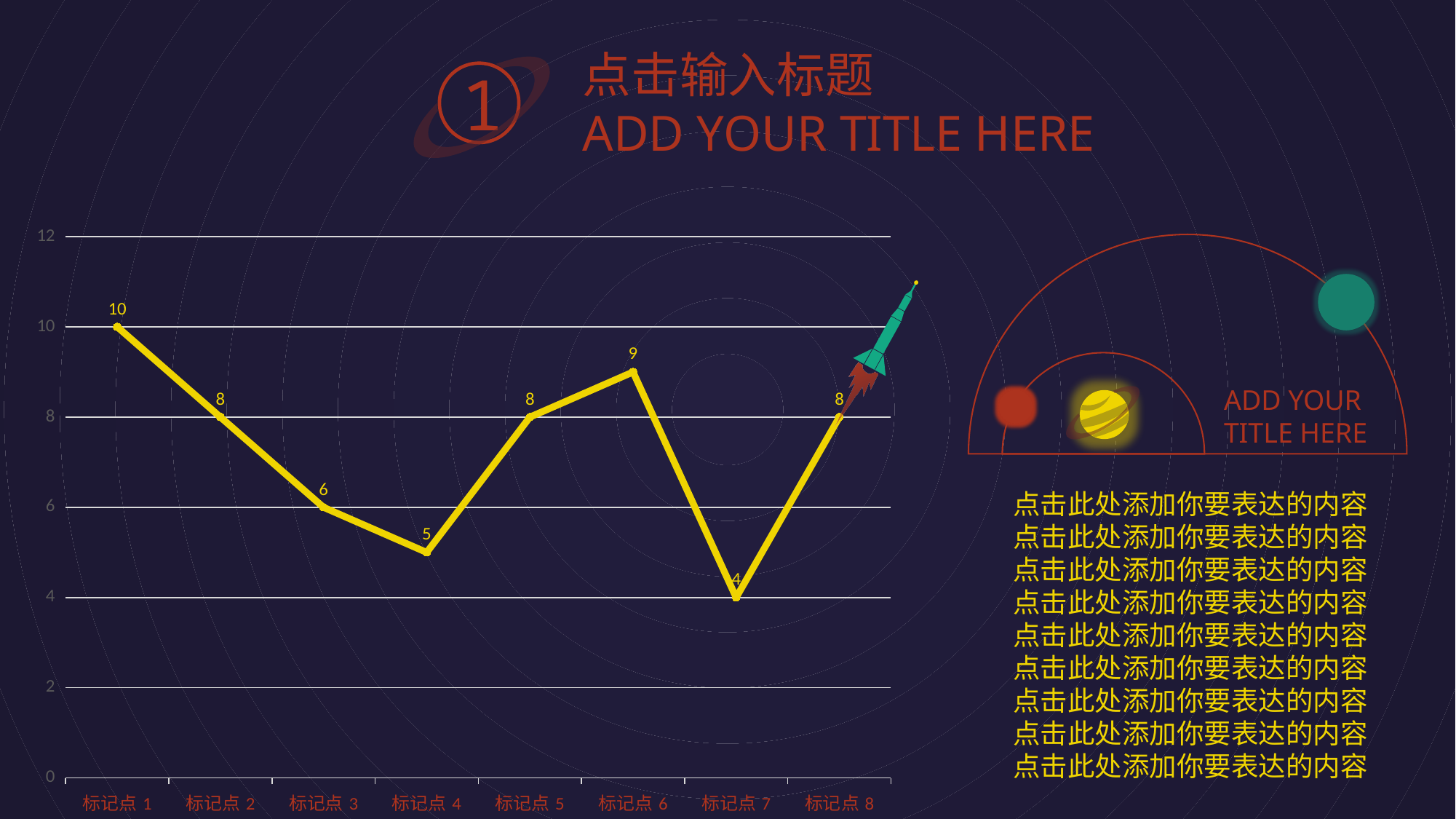
What kind of chart is shown on the slide? line chart Which point has the highest value? 标记点 1 Which is larger, the value at 标记点 2 or the value at 标记点 4? 标记点 2 What is the value at 标记点 7? 4 What is the difference between the values at 标记点 1 and 标记点 7? 6 Do the values rise or fall from 标记点 1 to 标记点 4? fall What is the value at 标记点 1? 10 What is the value at 标记点 6? 9 What is the value at 标记点 4? 5 How many data points are plotted on the line? 8 Which point has the lowest value? 标记点 7 What is the difference between the values at 标记点 6 and 标记点 3? 3